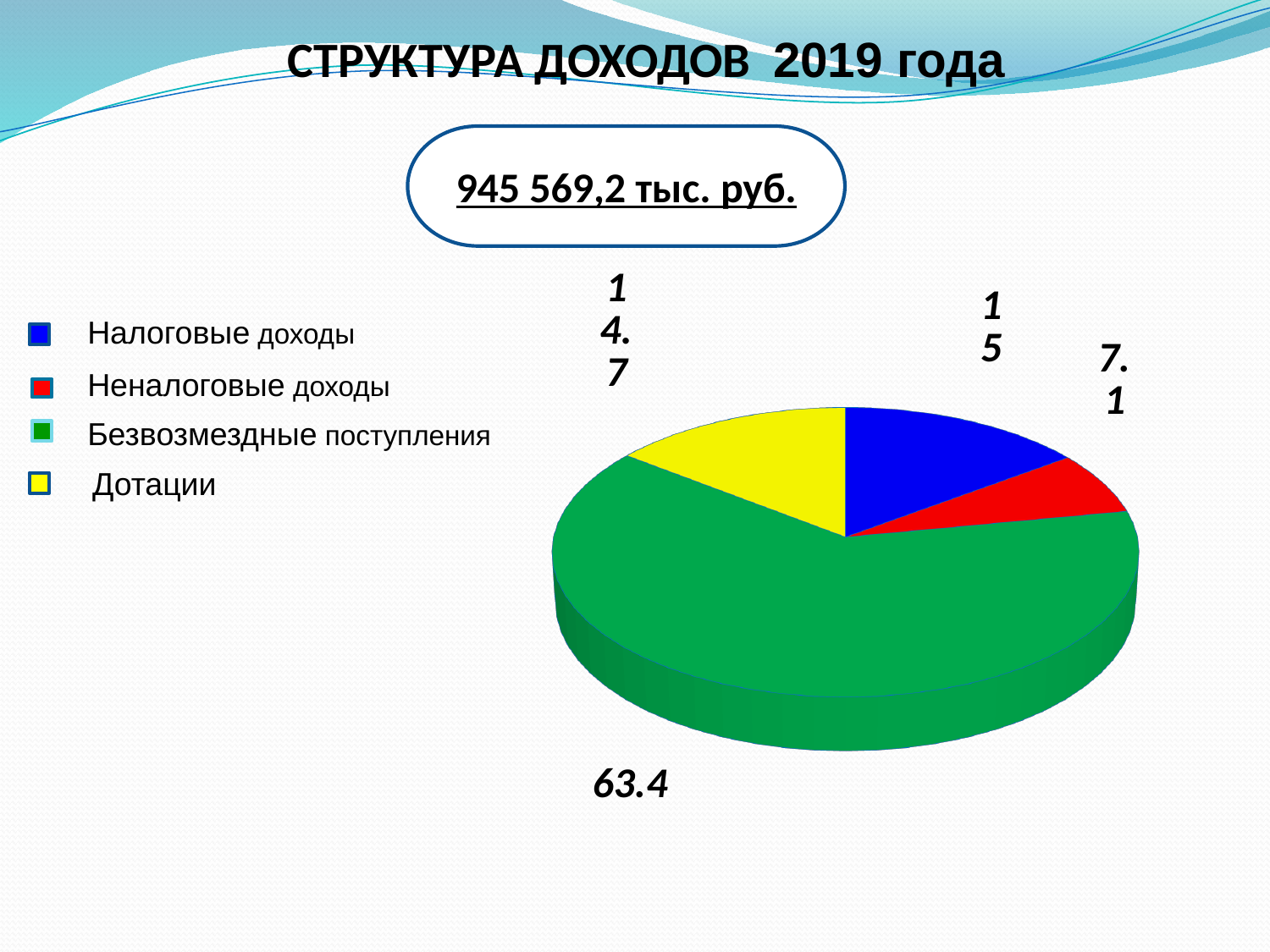
What is the value shown for Неналоговые доходы? 7.1 What is the difference between the values for Безвозмездные поступления and Налоговые доходы? 48.4 What is the value shown for Налоговые доходы? 15 Which is larger, the value for Налоговые доходы or the value for Неналоговые доходы? Налоговые доходы How many entries does the legend list? 4 What colour is the slice for Дотации? yellow Which category has the smallest slice of the pie? Неналоговые доходы What kind of chart is shown on the slide? pie chart What is the value shown for Дотации? 14.7 Which category has the largest slice of the pie? Безвозмездные поступления What is the value shown for Безвозмездные поступления? 63.4 How many slices does the pie chart have? 4